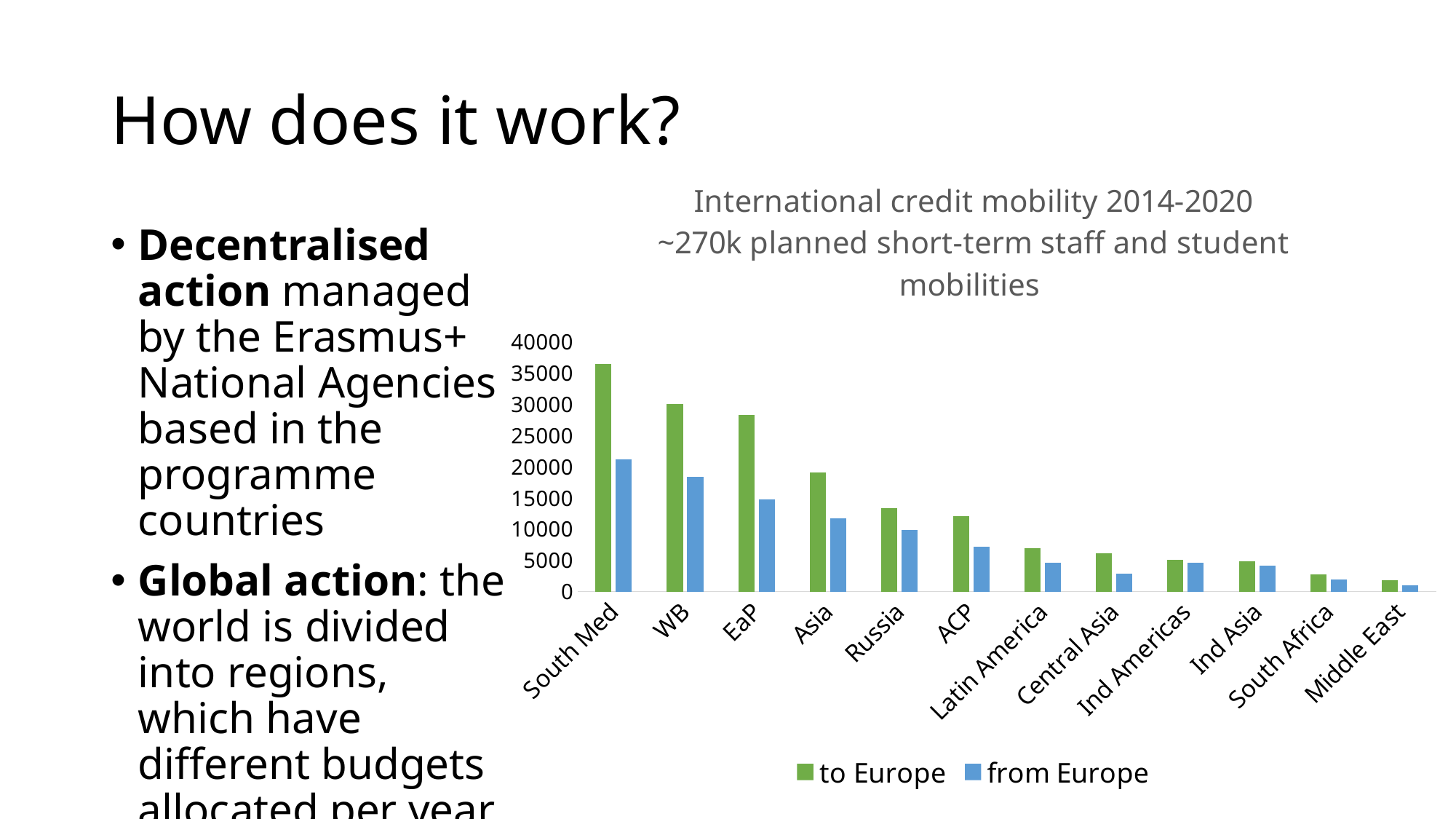
Is the 'from Europe' value for ACP greater or less than 5000? greater Is the 'to Europe' value for Asia greater or less than 20000? less Which region has the highest 'to Europe' value? South Med What kind of chart is shown on the slide? bar chart Is the 'to Europe' value for South Med greater or less than 35000? greater Which is larger for EaP: the 'to Europe' value or the 'from Europe' value? to Europe Do the 'to Europe' values rise or fall moving from left to right along the x axis? fall How many regions are shown on the x axis of the chart? 12 Which region has the lowest 'from Europe' value? Middle East How many series does the legend list? 2 What colour are the 'from Europe' bars in the chart? blue